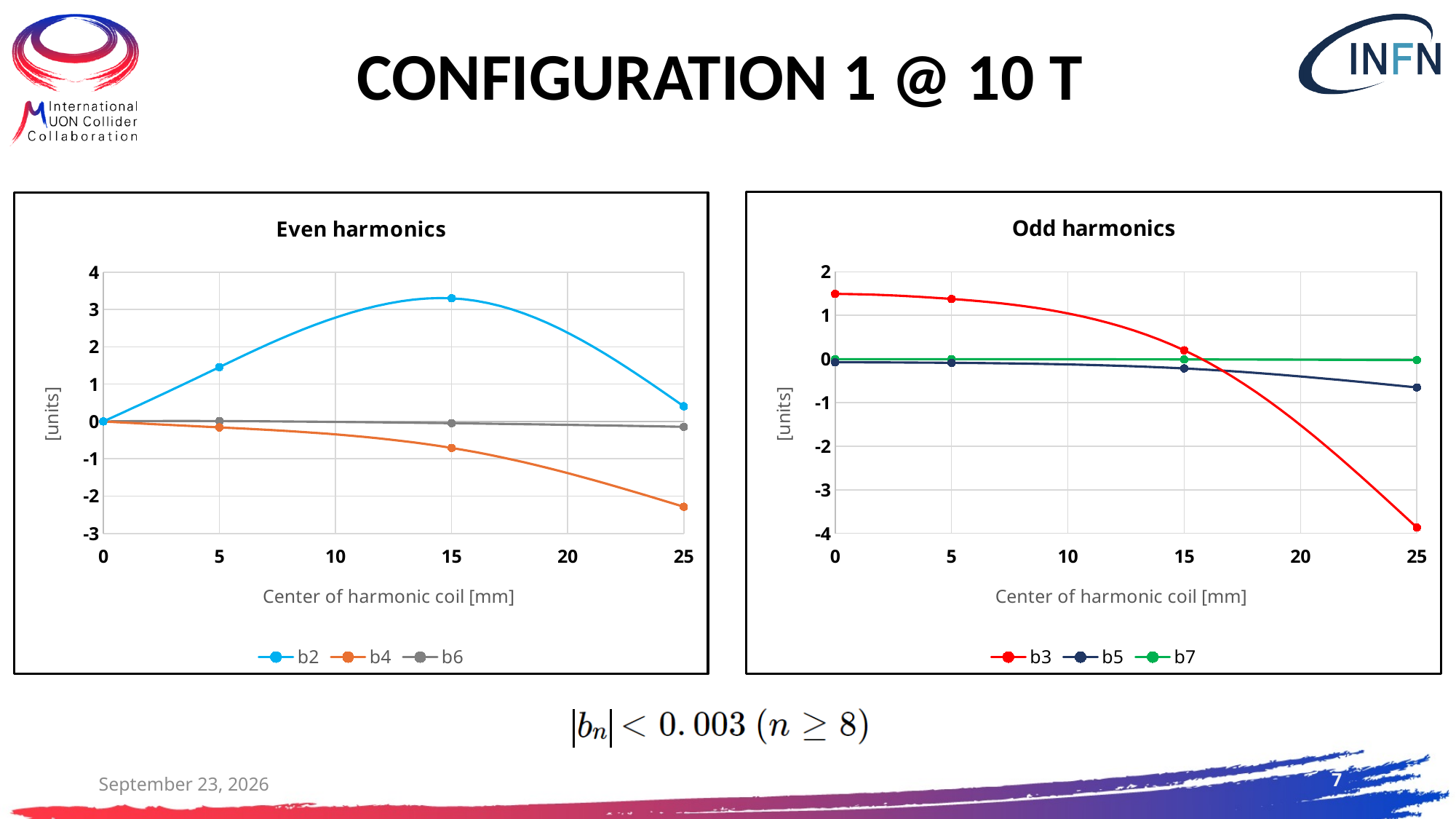
In the "Odd harmonics" chart, is the value of b3 at 0 mm greater or less than 1? greater In the "Even harmonics" chart, is the value of b4 at 25 mm greater or less than -2? less In the "Even harmonics" chart, at which x-axis position does b2 reach its highest value? 15 In the "Even harmonics" chart, is the value of b2 at 15 mm greater or less than 3? greater In the "Odd harmonics" chart, how many data points are plotted for the b3 series? 4 How many series does the legend of the "Odd harmonics" chart list? 3 In the "Odd harmonics" chart, at 25 mm, which is larger: b3 or b5? b5 In the "Odd harmonics" chart, does the b3 series rise or fall as the center of harmonic coil increases? falls How many series does the legend of the "Even harmonics" chart list? 3 What kind of chart is the "Even harmonics" chart? line chart In the "Even harmonics" chart, which series has the lowest value at 25 mm? b4 What is the x-axis title of the "Odd harmonics" chart? Center of harmonic coil [mm]